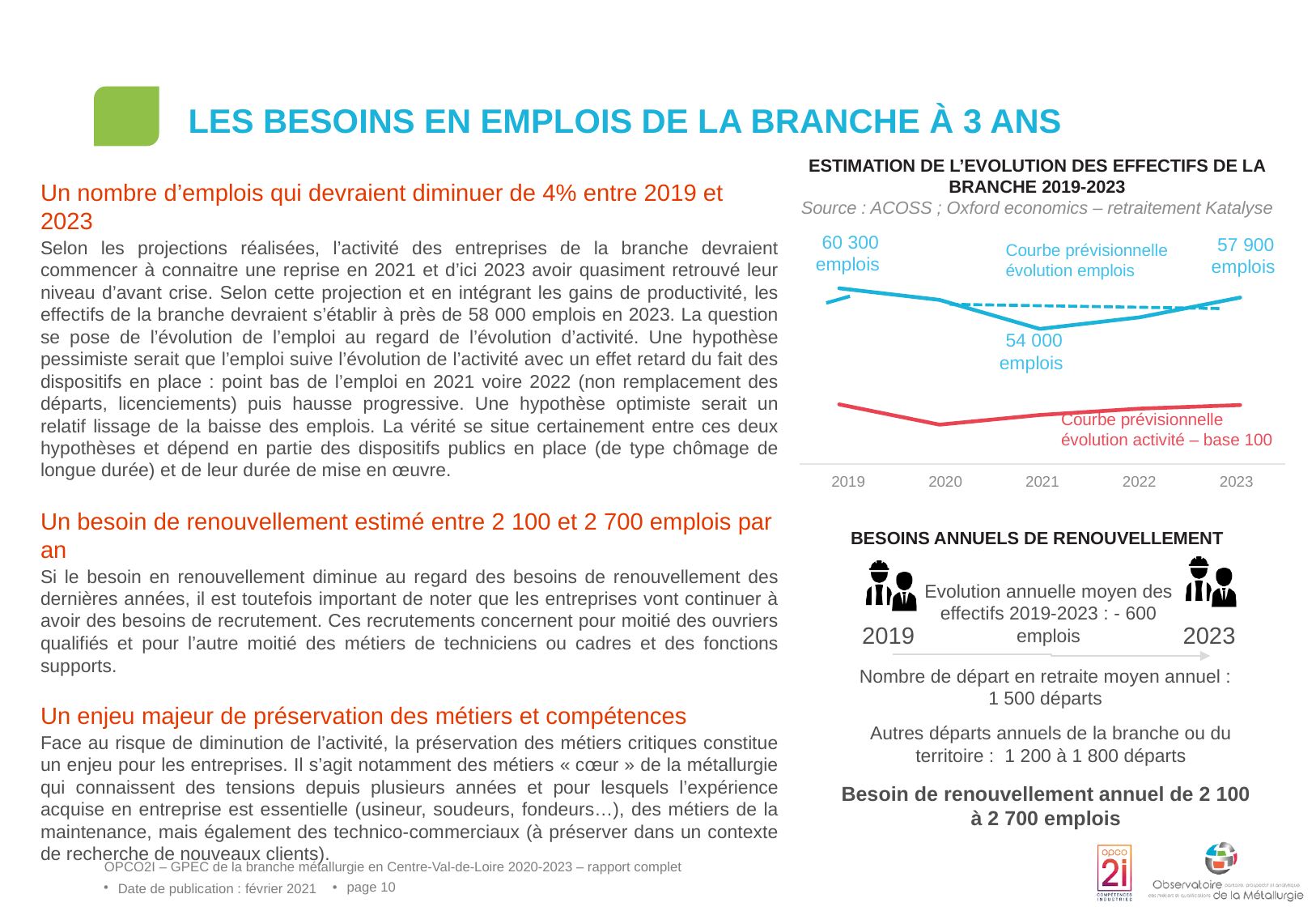
What type of chart is 'Estimation de l'évolution des effectifs de la branche 2019-2023'? Line chart In the chart 'Estimation de l'évolution des effectifs de la branche 2019-2023', is the number of jobs higher in 2019 or in 2023? 2019 In the chart 'Estimation de l'évolution des effectifs de la branche 2019-2023', how many years are shown on the x axis? 5 In the chart 'Estimation de l'évolution des effectifs de la branche 2019-2023', what is the difference between the number of jobs in 2019 and in 2021? 6 300 In the chart 'Estimation de l'évolution des effectifs de la branche 2019-2023', what is the number of jobs shown for 2019? 60 300 emplois In the chart 'Estimation de l'évolution des effectifs de la branche 2019-2023', what is the difference between the number of jobs in 2019 and in 2023? 2 400 In the chart 'Estimation de l'évolution des effectifs de la branche 2019-2023', which year has the highest labelled number of jobs? 2019 In the chart 'Estimation de l'évolution des effectifs de la branche 2019-2023', what is the number of jobs shown for 2021? 54 000 emplois In the chart 'Estimation de l'évolution des effectifs de la branche 2019-2023', what is the number of jobs shown for 2023? 57 900 emplois What source is cited for the chart 'Estimation de l'évolution des effectifs de la branche 2019-2023'? ACOSS ; Oxford economics – retraitement Katalyse In the chart 'Estimation de l'évolution des effectifs de la branche 2019-2023', does the jobs curve rise or fall between 2021 and 2023? Rise In the chart 'Estimation de l'évolution des effectifs de la branche 2019-2023', which year has the lowest labelled number of jobs? 2021